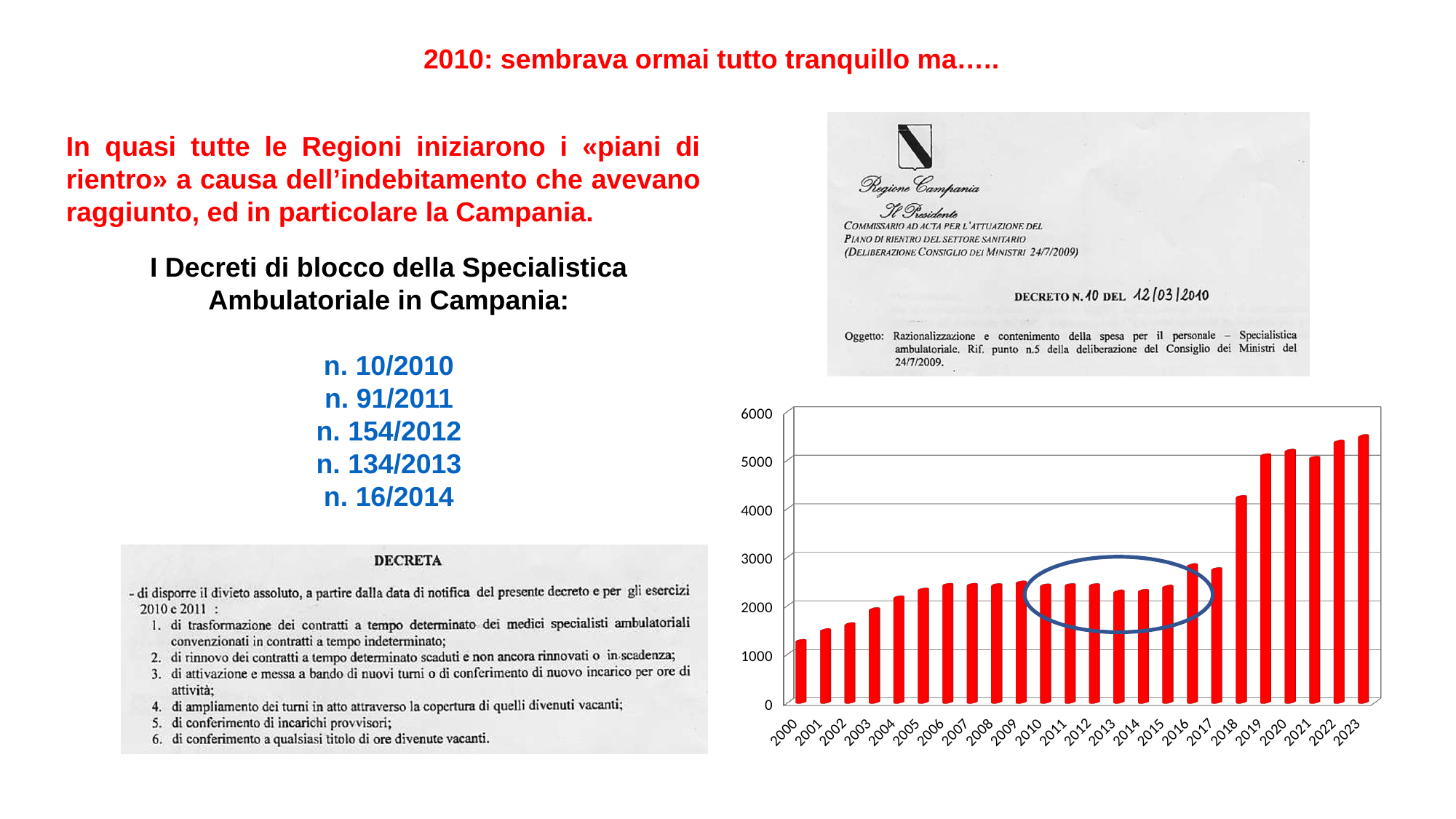
Which year has the larger value, 2000 or 2005? 2005 Is the value for 2018 greater or less than 4000? greater Which year has the lowest bar on the chart? 2000 What colour are the bars in the chart? red Which year has the larger value, 2017 or 2018? 2018 Is the value for 2016 greater or less than 3000? less How many years (bars) are plotted on the chart? 24 Is the value for 2010 greater or less than 2000? greater Do the values rise or fall from 2000 to 2009? rise What kind of chart is shown on the slide? bar chart